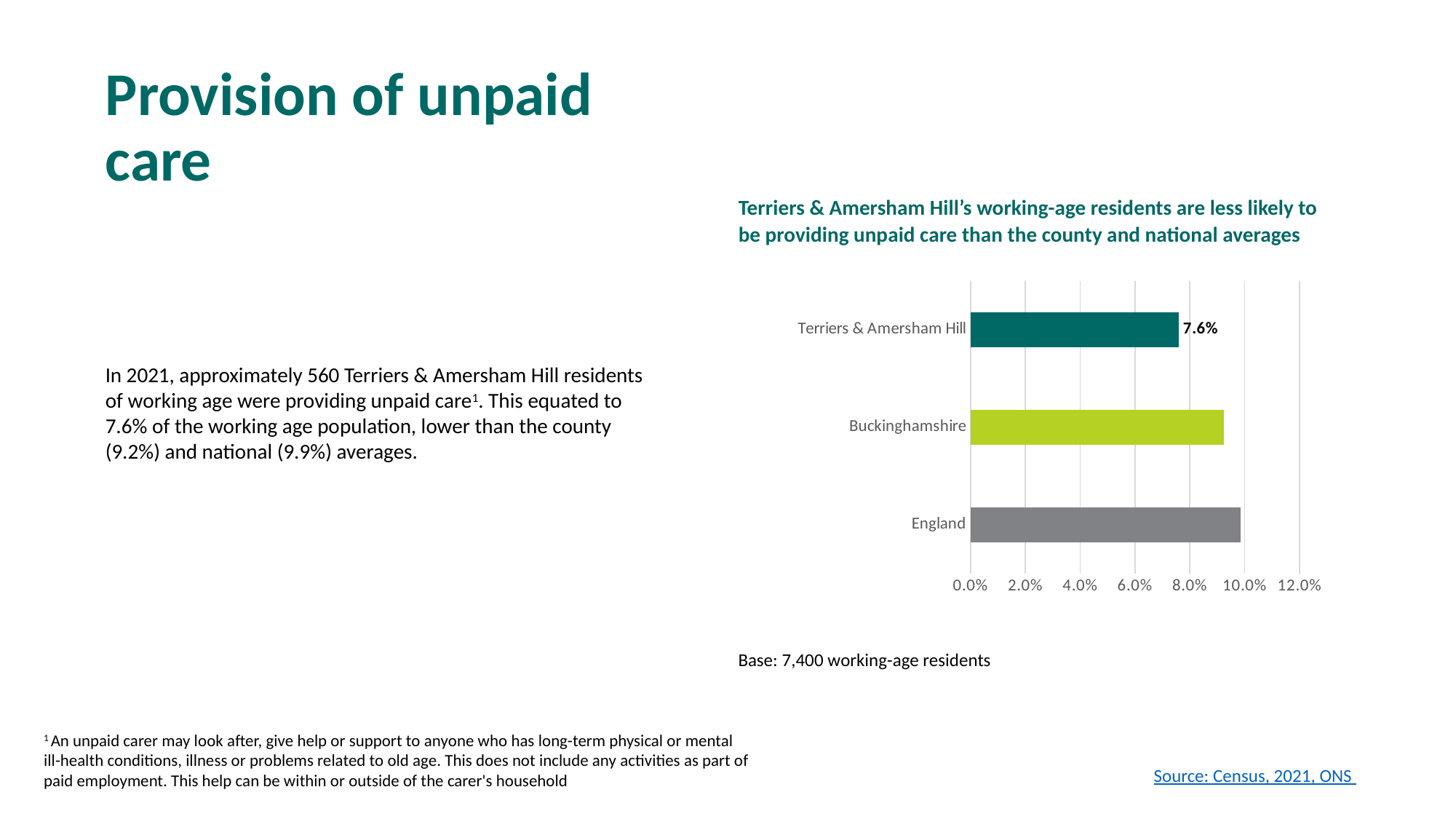
What kind of chart is shown on the slide? Bar chart Which category has the lowest value in the bar chart? Terriers & Amersham Hill What colour is the bar for Buckinghamshire in the chart? Green Which category has the highest value in the bar chart? England Which has the larger value in the chart, Buckinghamshire or England? England Is the value for Buckinghamshire greater or less than 8.0%? greater What is the title of the chart on the slide? Terriers & Amersham Hill's working-age residents are less likely to be providing unpaid care than the county and national averages What is the value shown for Terriers & Amersham Hill in the bar chart? 7.6% Which has the larger value in the chart, Terriers & Amersham Hill or Buckinghamshire? Buckinghamshire Is the value for Terriers & Amersham Hill greater or less than 8.0%? less How many categories are plotted in the bar chart? 3